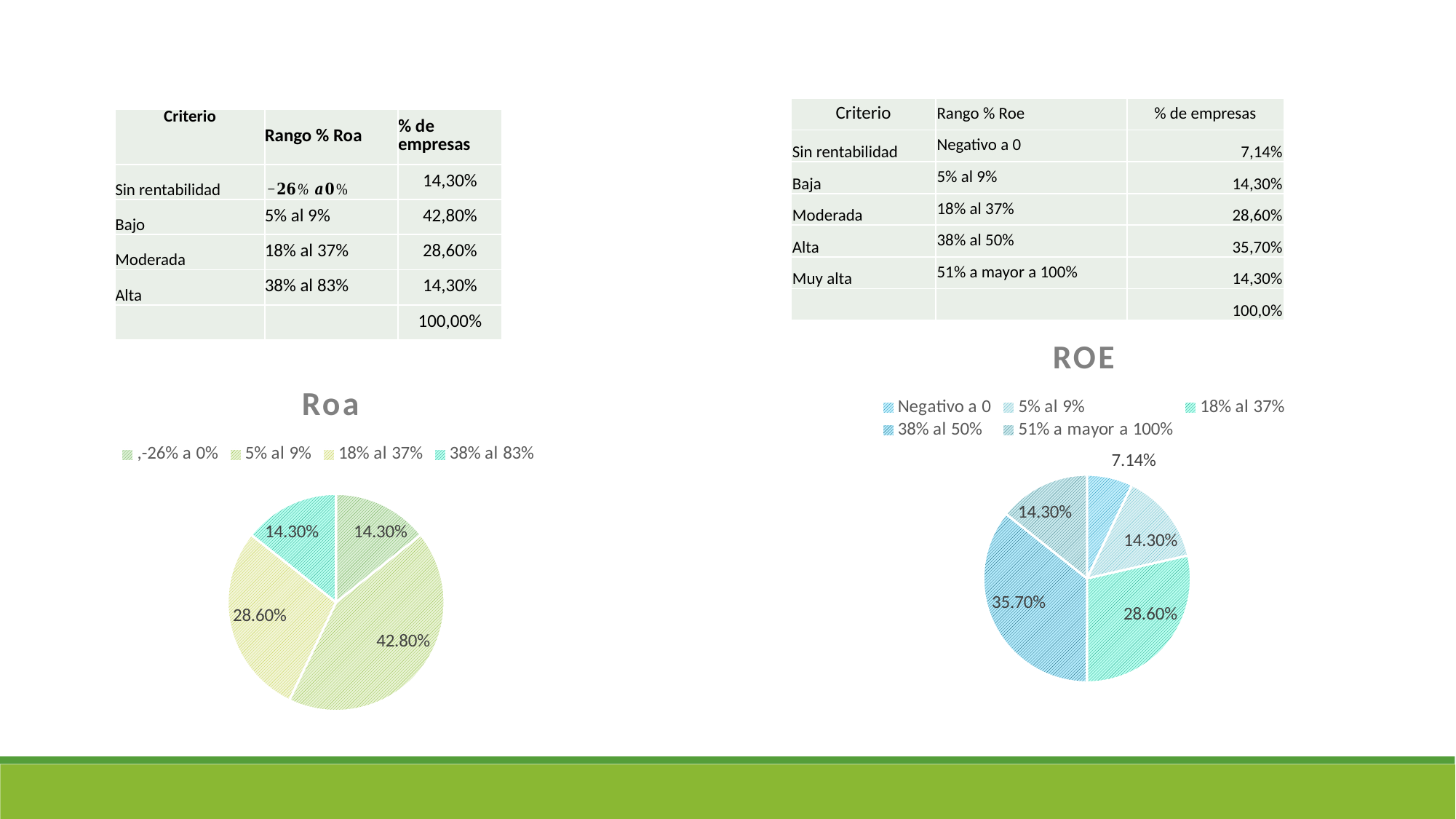
In the ROE chart, what share is labelled for the 38% al 50% slice? 35.70% In the Roa chart, what share is labelled for the 18% al 37% slice? 28.60% In the Roa chart, what is the difference between the 5% al 9% slice and the 18% al 37% slice? 14.20% In the Roa chart, which range has the largest slice? 5% al 9% In the ROE chart, which is larger: the 18% al 37% slice or the 5% al 9% slice? 18% al 37% In the Roa chart, what share is labelled for the 5% al 9% slice? 42.80% In the ROE chart, what share is labelled for the Negativo a 0 slice? 7.14% In the ROE chart, which range has the largest slice? 38% al 50% In the Roa chart, how many slices does the pie have? 4 In the ROE chart, which range has the smallest slice? Negativo a 0 In the ROE chart, how many entries does the legend list? 5 What type of chart is the ROE chart? Pie chart